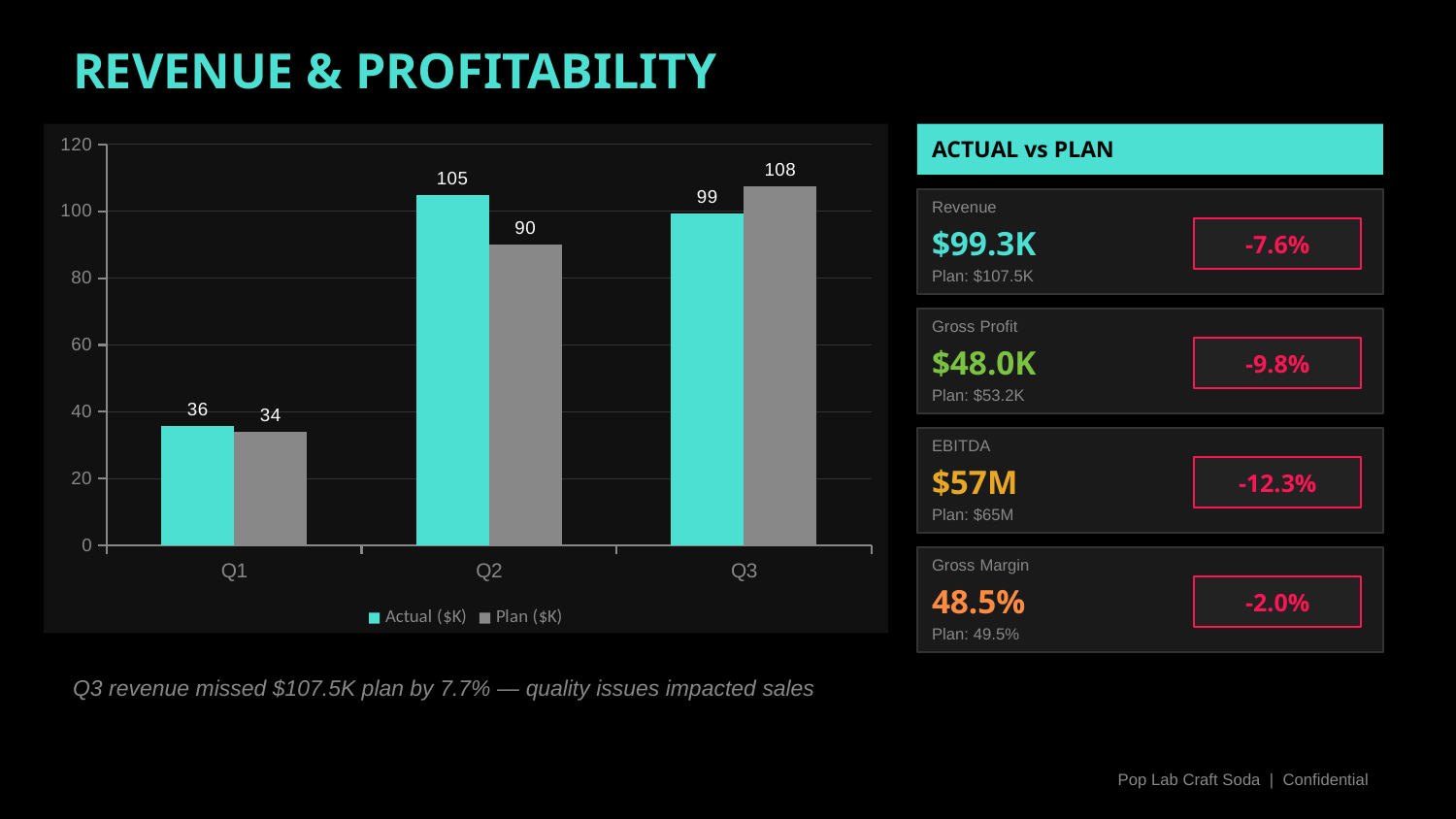
Which quarter has the lowest Plan ($K) value? Q1 Which is larger for Q3, the Actual ($K) value or the Plan ($K) value? Plan ($K) What is the Actual ($K) value for Q1? 36 How many series does the chart legend list? 2 Which quarter has the highest Actual ($K) value? Q2 What is the Actual ($K) value for Q2? 105 What is the difference between the Plan ($K) and Actual ($K) values for Q3? 9 What is the difference between the Actual ($K) and Plan ($K) values for Q2? 15 What kind of chart is shown on the slide? Bar chart Which colour represents the Plan ($K) series in the chart? Grey What is the Plan ($K) value for Q3? 108 How many quarters are shown on the x axis of the chart? 3